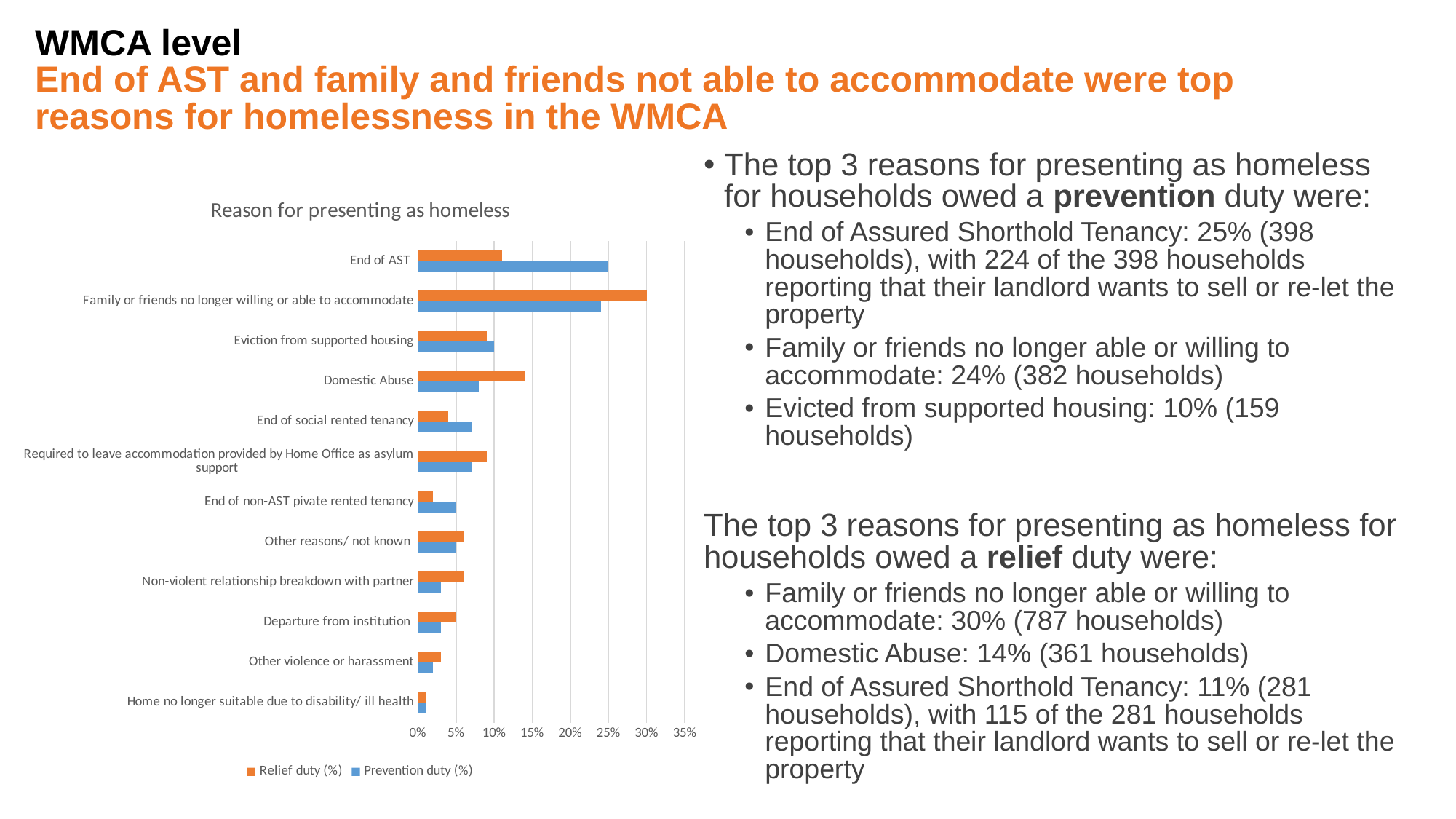
For End of AST, which is larger: the Relief duty (%) or the Prevention duty (%)? Prevention duty (%) How many reason categories are plotted on the chart? 12 Which reason has the highest Relief duty (%) value? Family or friends no longer willing or able to accommodate What is the Prevention duty (%) value for End of AST? 25% What is the title of the chart? Reason for presenting as homeless How many series does the chart legend list? 2 Which reason has the lowest Prevention duty (%) value? Home no longer suitable due to disability/ ill health For Domestic Abuse, which is larger: the Relief duty (%) or the Prevention duty (%)? Relief duty (%) Is the Prevention duty (%) value for Non-violent relationship breakdown with partner greater or less than 5%? less What is the Relief duty (%) value for Family or friends no longer willing or able to accommodate? 30% What kind of chart is shown on the slide? bar chart Is the Relief duty (%) value for Domestic Abuse greater or less than 10%? greater